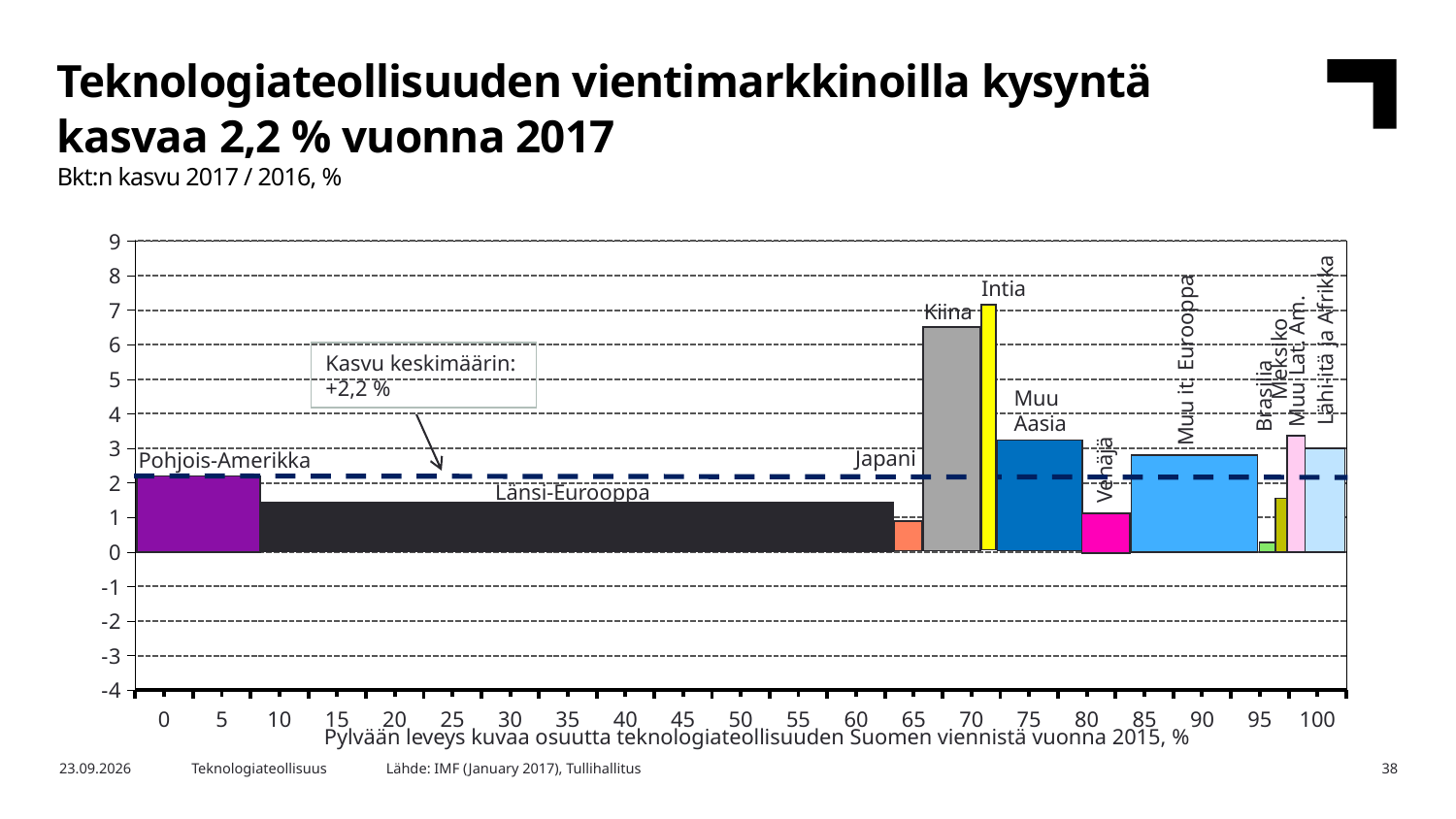
Is the value for Länsi-Eurooppa greater or less than 2? less Is the value for Intia greater or less than 6? greater Which region has the highest GDP growth in the chart? Intia Which has the higher value, Kiina or Japani? Kiina Which region has the lowest GDP growth in the chart? Brasilia Which has the higher value, Pohjois-Amerikka or Länsi-Eurooppa? Pohjois-Amerikka Is the value for Japani greater or less than 2? less Which region has the widest bar in the chart? Länsi-Eurooppa How many regions are shown as bars in the chart? 12 What average growth value is printed in the text box on the chart? +2,2 % What kind of chart is shown on the slide? Bar chart